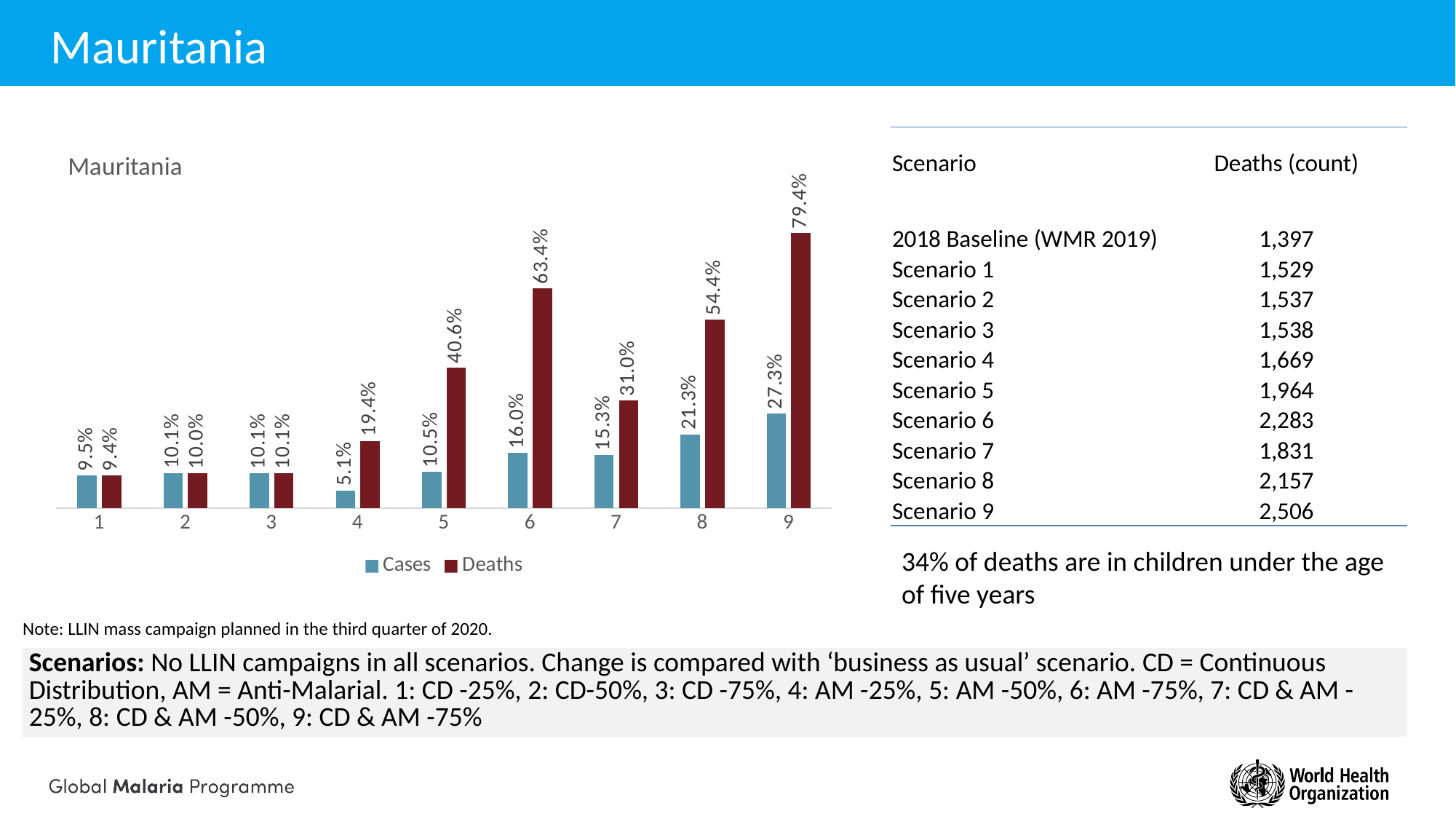
How many scenarios are shown on the x axis of the chart? 9 What is the Deaths value for scenario 6? 63.4% What is the Cases value for scenario 9? 27.3% What kind of chart is shown on the slide? Bar chart How many series does the chart legend list? 2 Which scenario has the lowest Cases value? 4 What colour are the Deaths bars in the chart? Dark red Which is larger for scenario 7: the Cases value or the Deaths value? Deaths Which scenario has the highest Deaths value? 9 Do the Deaths values rise or fall from scenario 4 to scenario 6? Rise What is the Deaths value for scenario 4? 19.4% What is the difference between the Deaths and Cases values for scenario 9? 52.1%